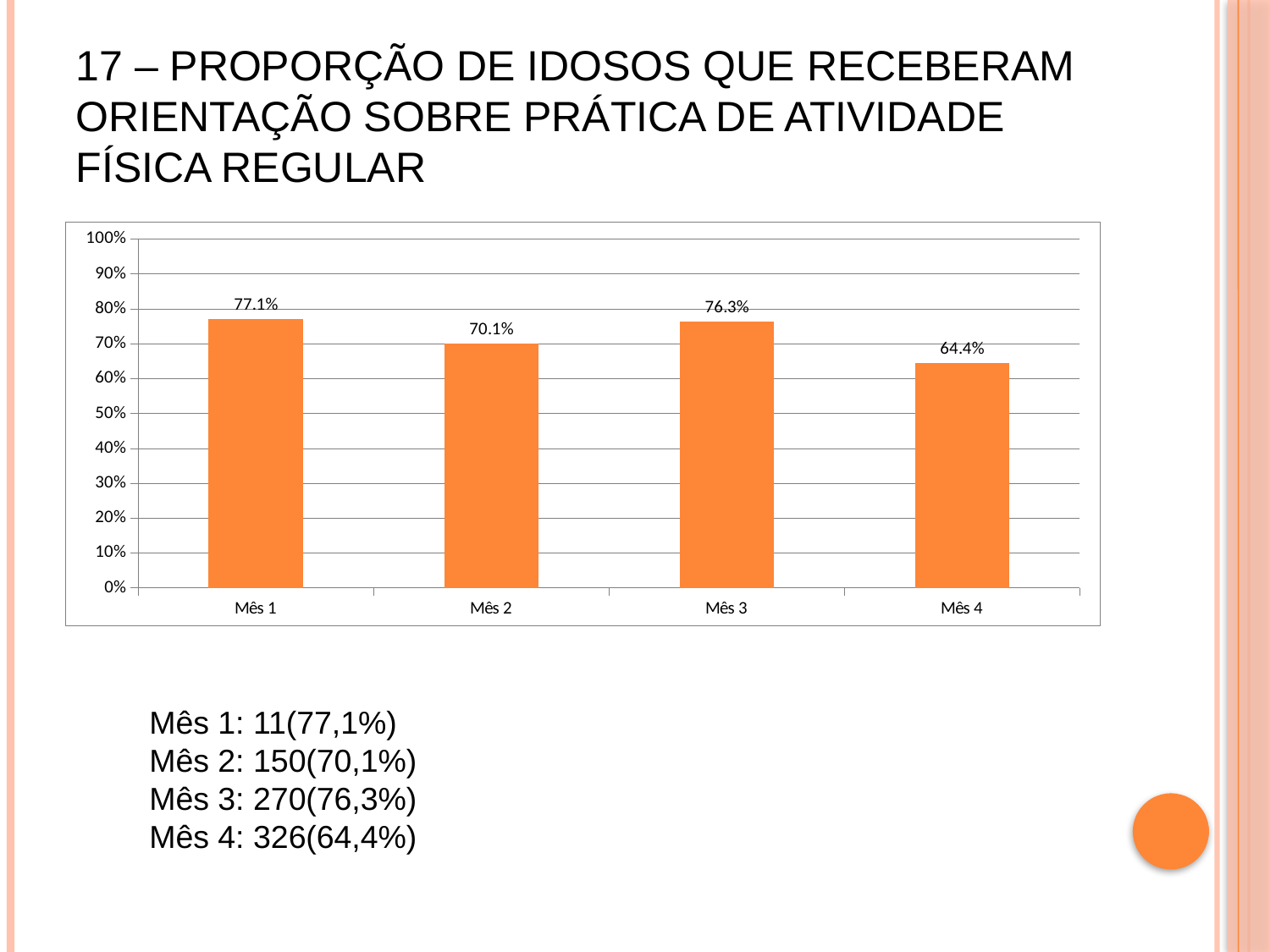
What is the difference between the values for Mês 1 and Mês 2? 7.0 percentage points Which is larger, the value for Mês 2 or the value for Mês 3? Mês 3 Is the value for Mês 2 greater or less than 80%? less What is the value shown for Mês 1? 77.1% What is the difference between the values for Mês 1 and Mês 4? 12.7 percentage points Which month has the lowest value? Mês 4 What kind of chart is shown on the slide? bar chart What is the value shown for Mês 3? 76.3% What is the value shown for Mês 4? 64.4% What is the value shown for Mês 2? 70.1% How many months are shown on the x axis? 4 Which month has the highest value? Mês 1